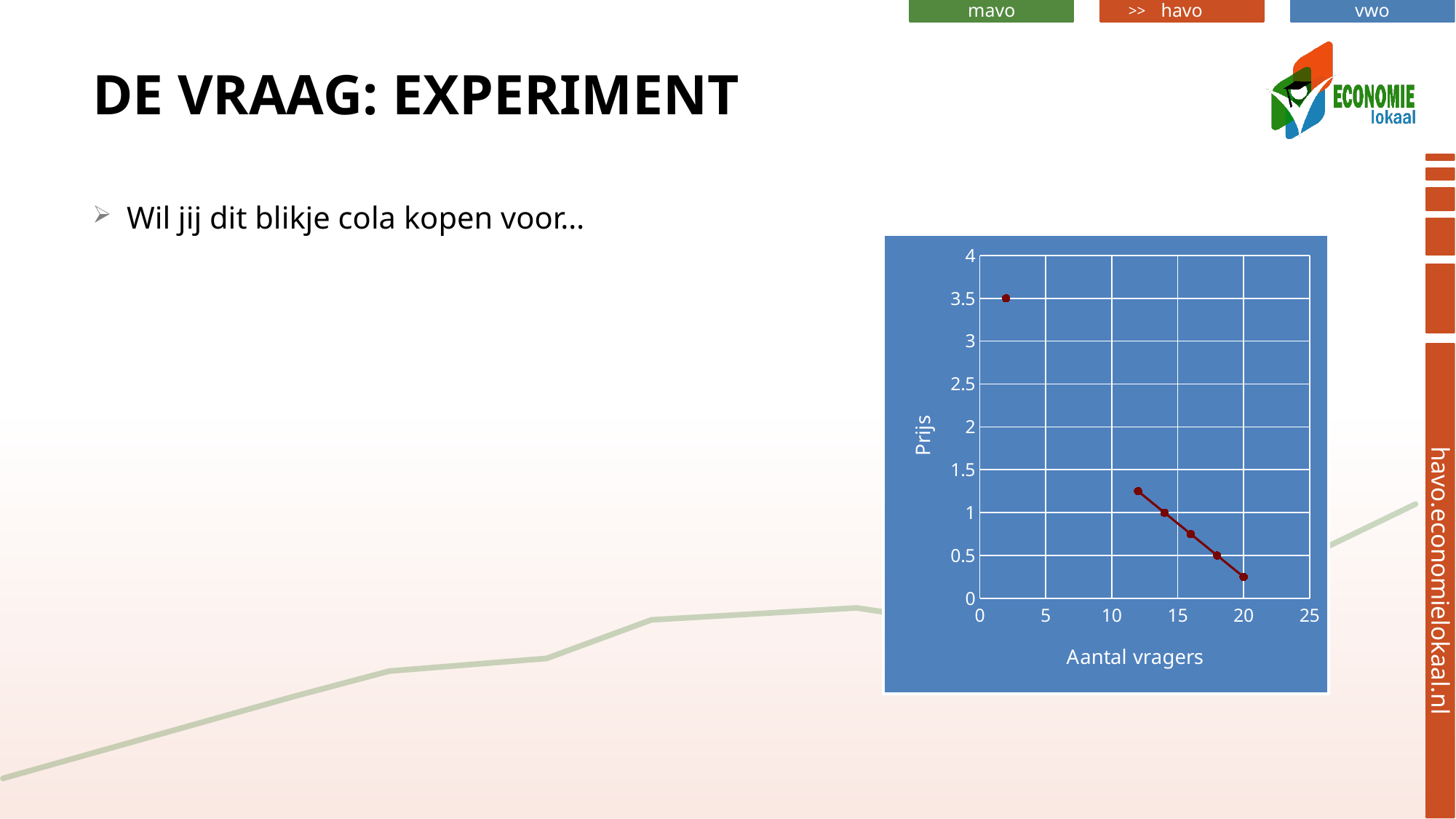
Which has the higher price: the point at 20 demanders or the point at about 12 demanders? the point at about 12 demanders What is the highest value shown on the horizontal axis? 25 What is the label of the horizontal axis? Aantal vragers Is the price of the point at 20 demanders greater or less than 1? less Is the number of demanders for the highest-priced point greater or less than 5? less Is the price of the rightmost point greater or less than 0.5? less How many demanders (Aantal vragers) does the rightmost point correspond to? 20 How many data points are plotted on the chart? 6 What is the label of the vertical axis? Prijs Does the price rise or fall as the number of demanders (Aantal vragers) increases? fall What kind of chart is shown on the slide? scatter chart